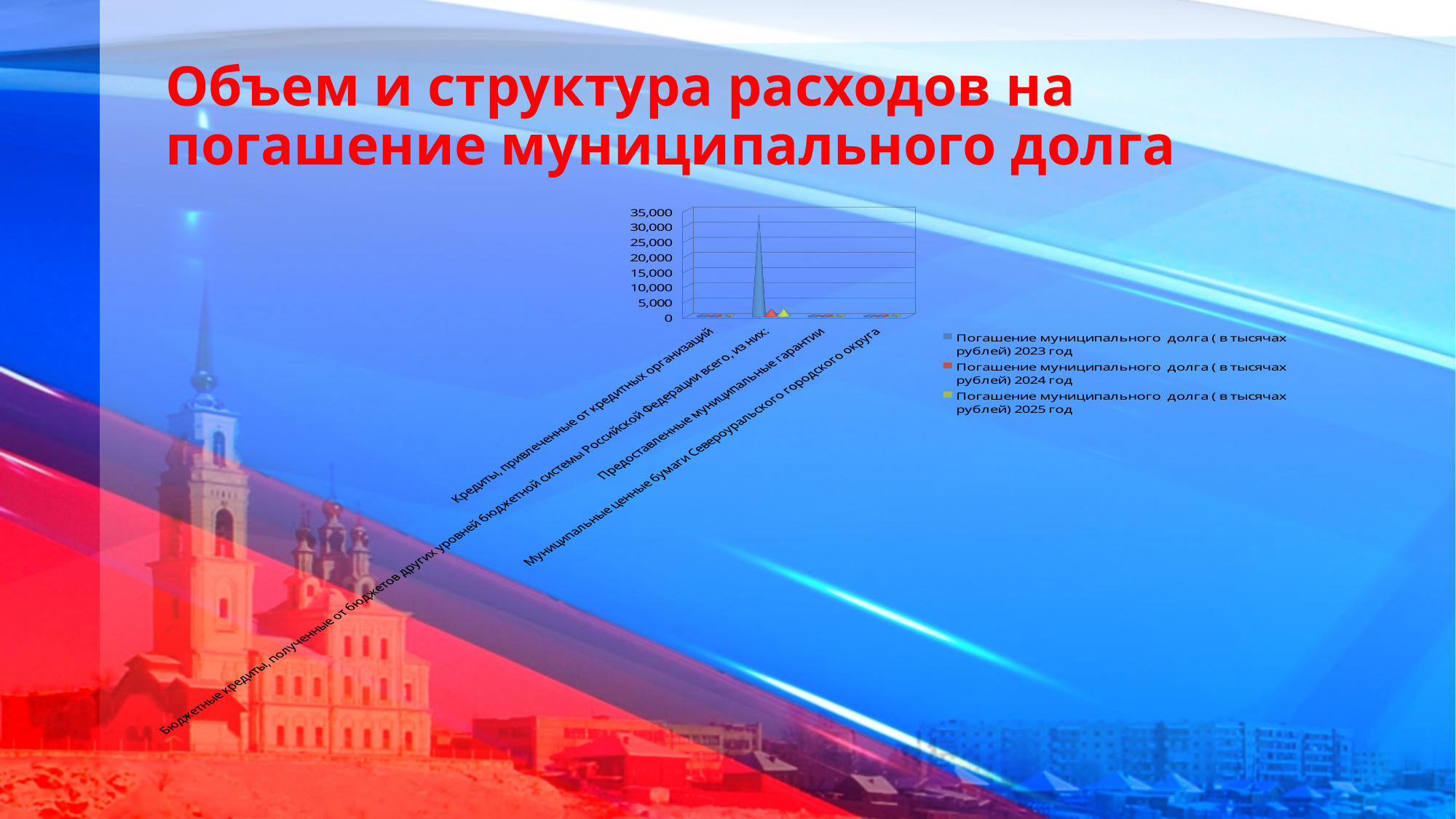
Is the 2024 value for 'Бюджетные кредиты, полученные от бюджетов других уровней бюджетной системы Российской Федерации всего, из них:' greater or less than 10,000? less Is the 2023 value for 'Бюджетные кредиты, полученные от бюджетов других уровней бюджетной системы Российской Федерации всего, из них:' greater or less than 25,000? greater How many series does the chart legend list? 3 What is the highest value shown on the chart's vertical axis? 35,000 For the category 'Бюджетные кредиты, полученные от бюджетов других уровней бюджетной системы Российской Федерации всего, из них:', which series has the largest value? Погашение муниципального долга ( в тысячах рублей) 2023 год Is the 2025 value for 'Предоставленные муниципальные гарантии' greater or less than 5,000? less For 'Бюджетные кредиты, полученные от бюджетов других уровней бюджетной системы Российской Федерации всего, из них:', which is larger: the 2023 value or the 2024 value? 2023 What is the title of the slide containing the chart? Объем и структура расходов на погашение муниципального долга Which category has the highest value for the 2023 series (Погашение муниципального долга 2023 год)? Бюджетные кредиты, полученные от бюджетов других уровней бюджетной системы Российской Федерации всего, из них: How many categories are shown on the chart's horizontal axis? 4